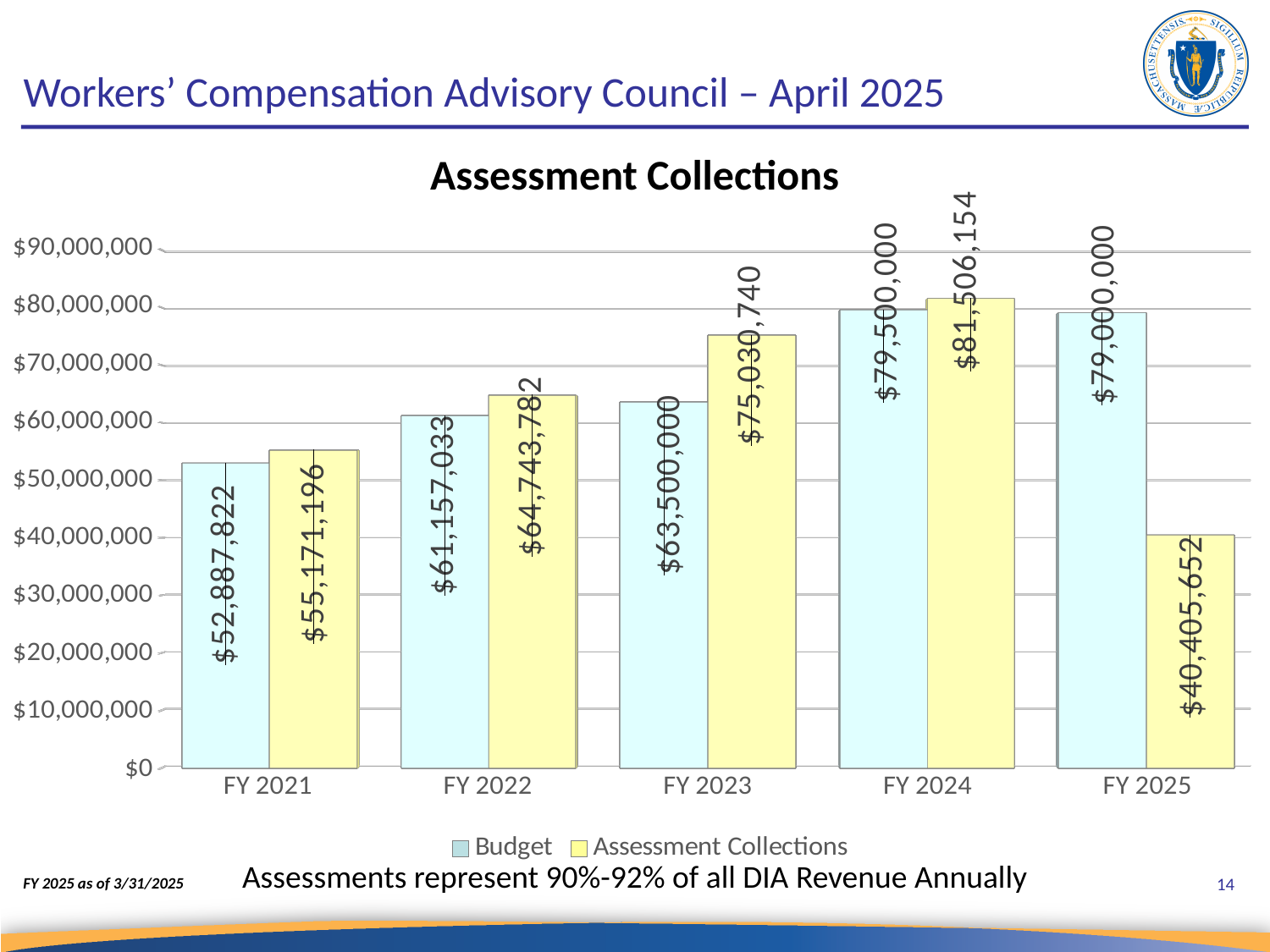
For FY 2021, which is larger: Budget or Assessment Collections? Assessment Collections What is the difference between Assessment Collections and Budget for FY 2023? $11,530,740 What is the Budget value for FY 2023? $63,500,000 What is the difference between Budget and Assessment Collections for FY 2025? $38,594,348 Which fiscal year has the lowest Assessment Collections value? FY 2025 Is the Assessment Collections value for FY 2024 greater or less than $80,000,000? greater What is the Assessment Collections value for FY 2025? $40,405,652 Which fiscal year has the highest Assessment Collections value? FY 2024 How many fiscal years are shown on the x axis? 5 What kind of chart is shown on the slide? bar chart What is the Assessment Collections value for FY 2022? $64,743,782 How many series does the legend list? 2